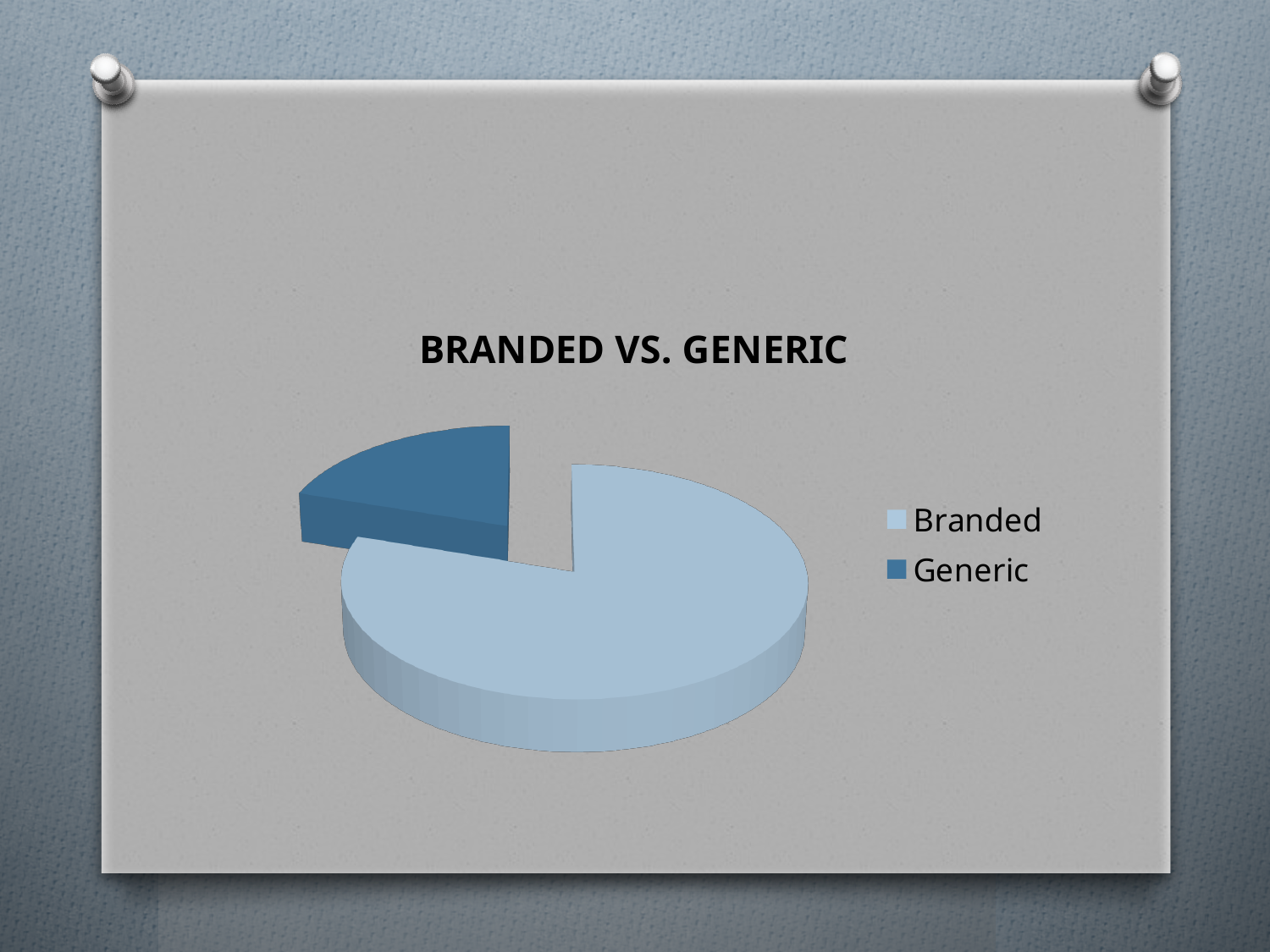
How many entries does the legend list? 2 What kind of chart is shown on the slide? pie chart Which slice is pulled out (exploded) from the rest of the pie? Generic What is the title of the chart? BRANDED VS. GENERIC Which slice is the largest in the pie chart? Branded Which legend entry is shown in the darker blue colour? Generic Which slice is the smallest in the pie chart? Generic How many slices does the pie chart have? 2 Which is larger, the Branded slice or the Generic slice? Branded